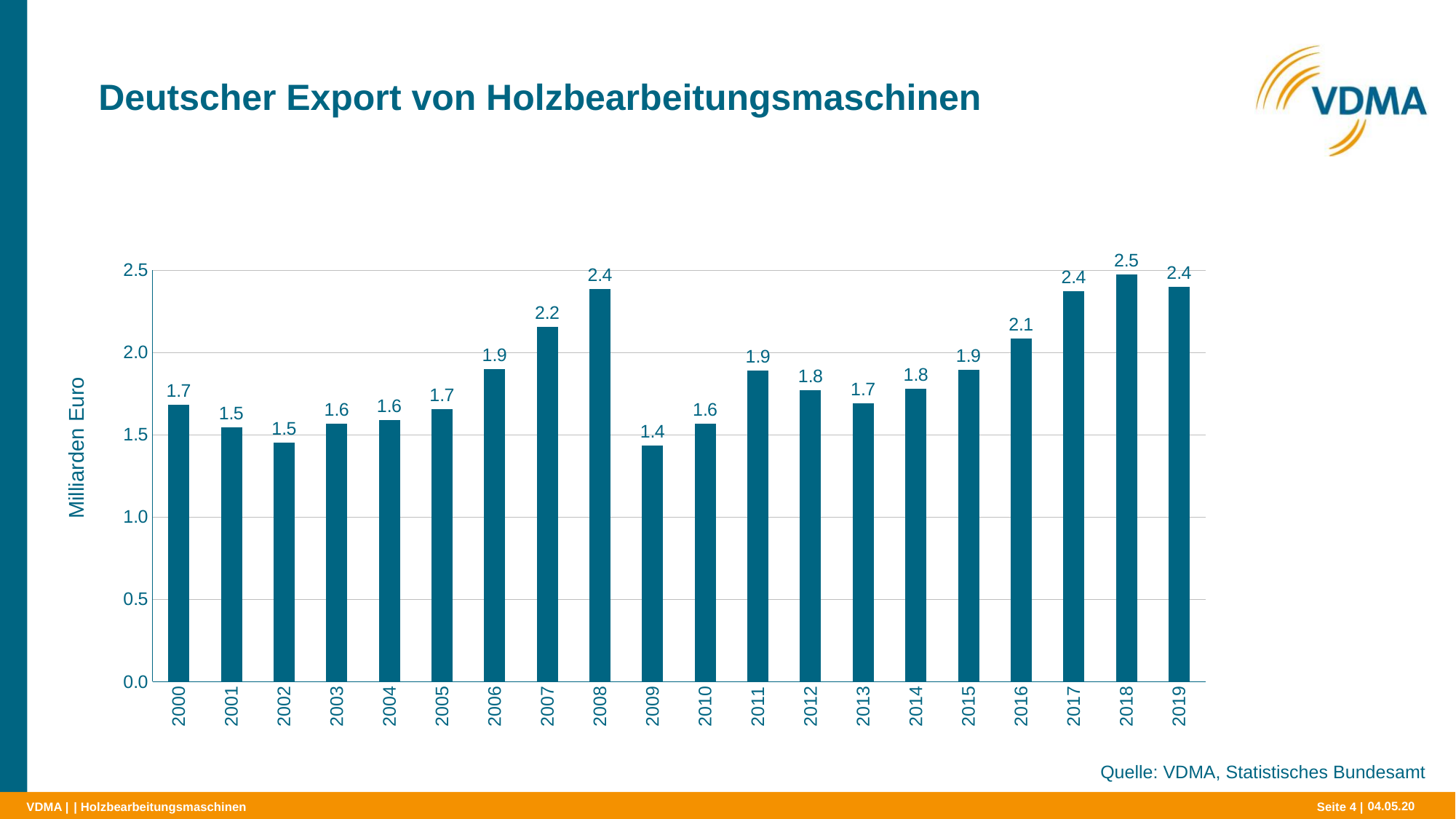
What is the difference between the values for 2008 and 2009? 1.0 Do the values rise or fall from 2009 to 2018? rise What unit is shown on the y axis label? Milliarden Euro What type of chart is shown on the slide? bar chart What is the value for 2019? 2.4 How many years are shown on the x axis? 20 What is the value for 2008? 2.4 What is the value for 2009? 1.4 Is the value for 2016 greater or less than 2.0? greater Which is larger, the value for 2008 or the value for 2011? 2008 Which year has the lowest value? 2009 Which year has the highest value? 2018